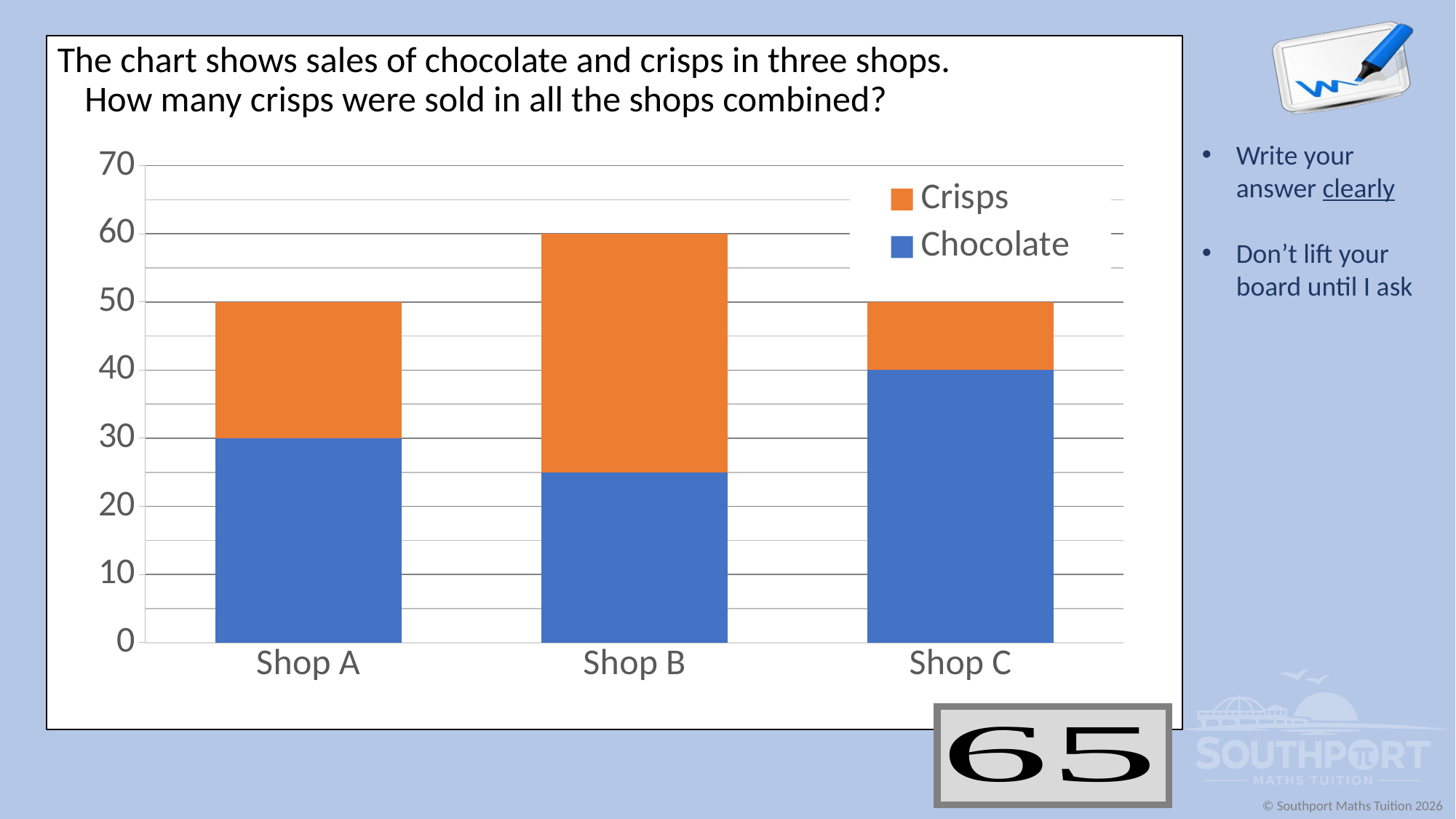
What kind of chart is shown on the slide? bar chart What is the total height of the stacked bar for Shop A? 50 How many series does the legend list? 2 How many shops are shown on the x axis? 3 What is the Chocolate value for Shop A? 30 What is the Chocolate value for Shop C? 40 Which shop has the lowest Chocolate value? Shop B What is the total height of the stacked bar for Shop B? 60 Is the Chocolate value for Shop B greater or less than 30? less Which colour represents Crisps in the legend? orange Which is larger, the Chocolate value for Shop A or for Shop C? Shop C Which shop has the highest total stacked bar? Shop B